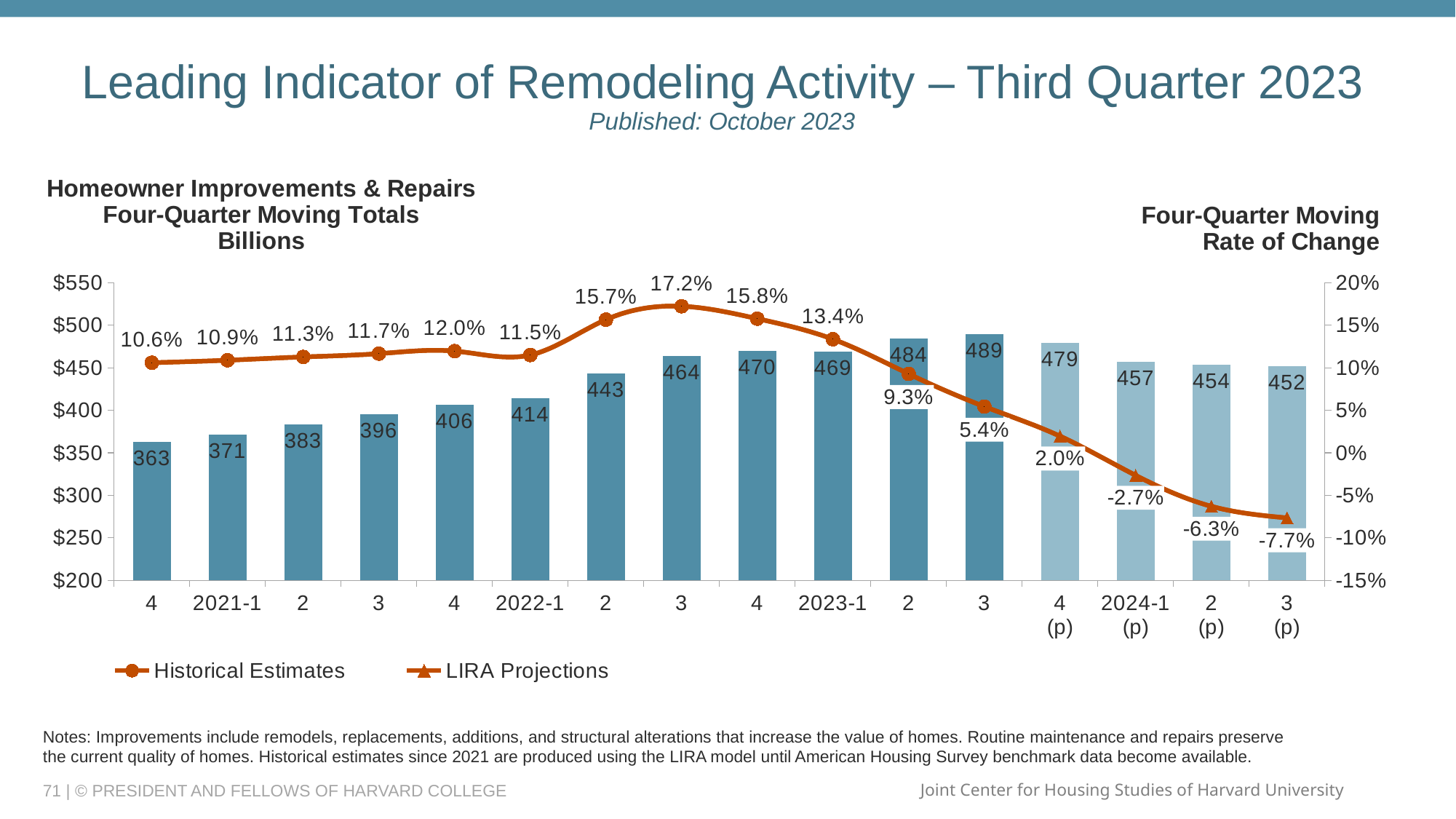
Which quarter has the highest four-quarter moving total bar? 2023 Q3 (489) How many series does the legend list? 2 Does the four-quarter moving rate of change rise or fall from 2022 Q3 to 2024 Q3 (p)? fall What is the four-quarter moving rate of change for the third quarter of 2022? 17.2% What is the projected four-quarter moving rate of change for 2024-1 (p)? -2.7% What is the difference between the four-quarter moving totals for 2023 Q3 and 2024 Q3 (p)? 37 Which quarter has the lowest four-quarter moving rate of change? 2024 Q3 (p) (-7.7%) How many quarters are plotted along the x axis? 16 Which is larger, the four-quarter moving total for 2022 Q4 or for 2023 Q4 (p)? 2023 Q4 (p) (479) What kind of chart is shown on the slide? Combined bar and line chart Is the four-quarter moving total for 2021-1 greater or less than $400? less What is the four-quarter moving total (in billions) for 2023-1? 469